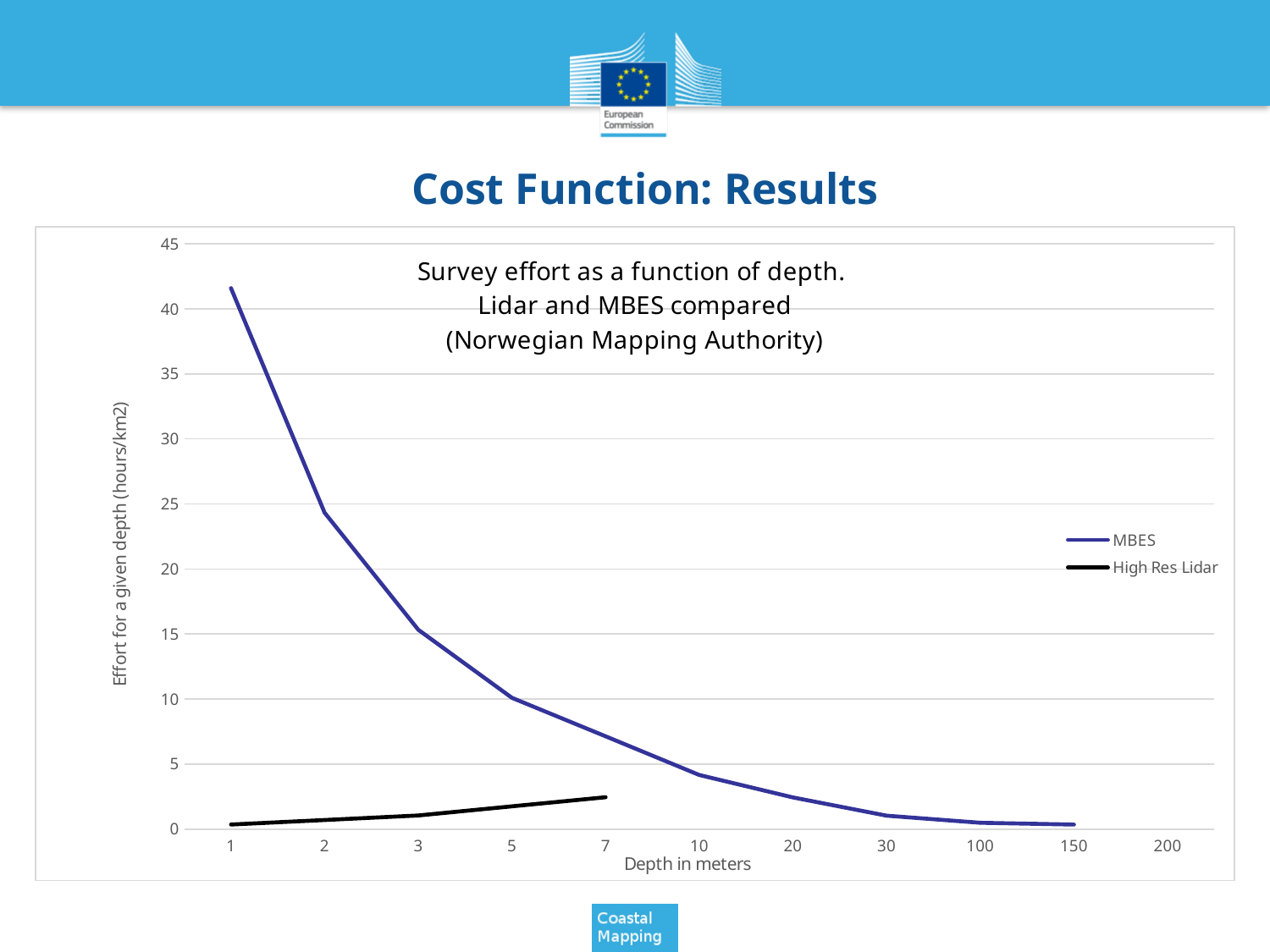
At a depth of 1 meter, which series has the larger value, MBES or High Res Lidar? MBES Which colour is used for the High Res Lidar series? black Is the MBES value at a depth of 10 meters greater or less than 5? less Is the MBES value at a depth of 1 meter greater or less than 40? greater Is the MBES value at a depth of 2 meters greater or less than 25? less How many depth categories are shown on the x axis? 11 Does the MBES series rise or fall as depth increases along the x axis? fall What kind of chart is shown on the slide? line chart How many series does the legend list? 2 What is the label of the y axis? Effort for a given depth (hours/km2) At which depth does the MBES series reach its highest value? 1